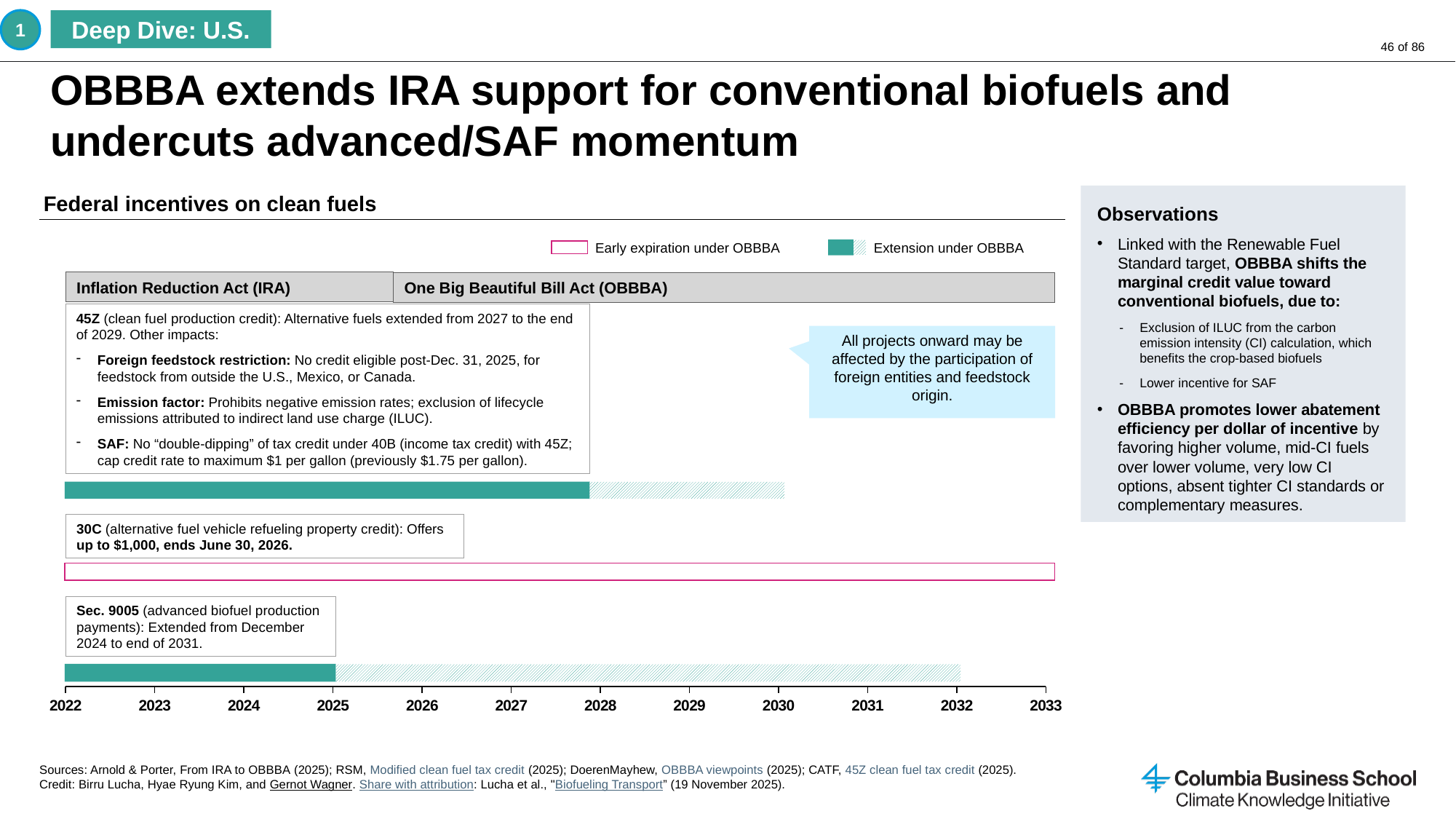
To what year is Sec. 9005 (advanced biofuel production payments) extended under OBBBA? End of 2031 How many entries does the legend of the timeline chart list? 2 What is the first year shown on the x axis of the timeline? 2022 From what date was Sec. 9005 originally set to expire before the OBBBA extension? December 2024 How many federal incentives are plotted as bars on the timeline? 3 What is the maximum credit rate per gallon for SAF under 45Z after OBBBA? $1 per gallon When does the 30C alternative fuel vehicle refueling property credit end? June 30, 2026 Which incentive on the timeline is marked with the 'Early expiration under OBBBA' style? 30C What kind of chart is shown under 'Federal incentives on clean fuels'? A timeline (Gantt-style horizontal bar) chart To what year is the 45Z clean fuel production credit extended under OBBBA? End of 2029 Which incentive's extension under OBBBA runs later: 45Z or Sec. 9005? Sec. 9005 What is the last year shown on the x axis of the timeline? 2033